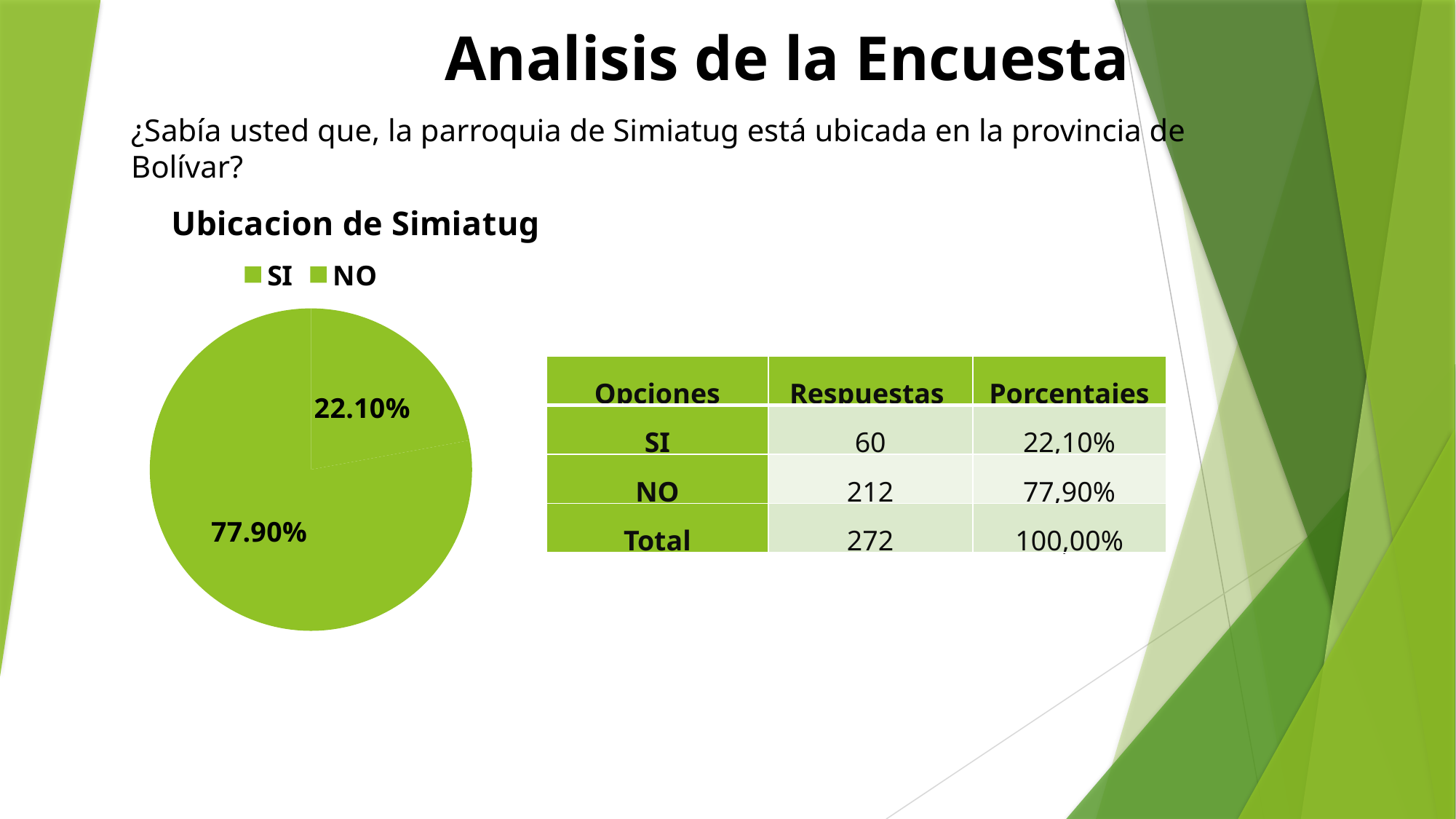
What share of the pie does the SI slice represent? 22.10% What share of the pie does the NO slice represent? 77.90% What are the legend entries of the chart? SI, NO How many entries does the chart legend list? 2 Which slice is larger, SI or NO? NO Which slice of the pie is the smallest? SI Which slice of the pie is the largest? NO What is the title of the chart? Ubicacion de Simiatug What kind of chart is shown on the slide? pie chart What is the difference in percentage points between the NO slice and the SI slice? 55.80% How many slices does the pie chart have? 2